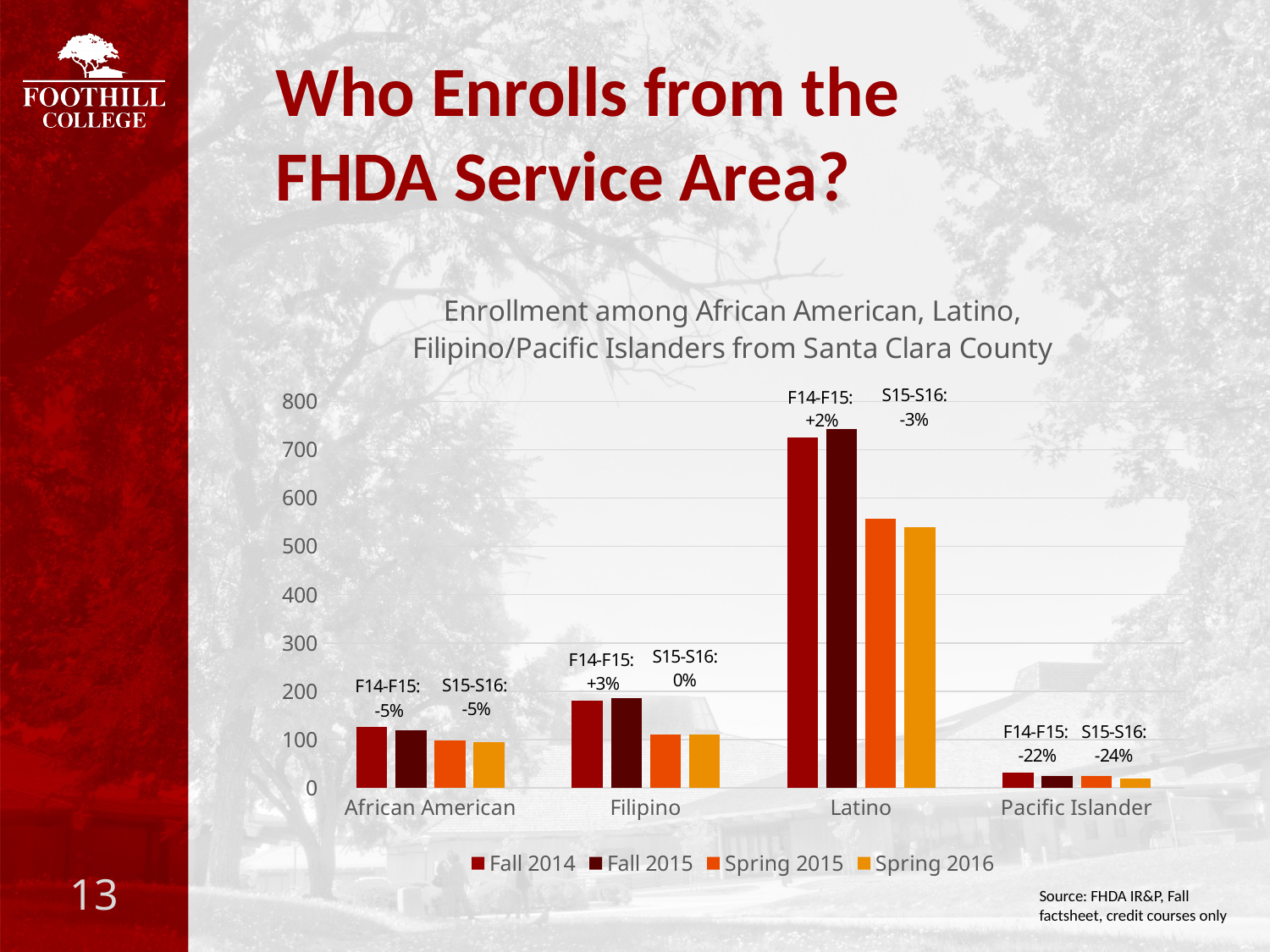
What kind of chart is shown on the slide? bar chart Is the Fall 2014 value for Filipino greater or less than 100? greater Which category has the lowest enrollment in the chart? Pacific Islander Which is larger: the Fall 2014 value for Latino or the Fall 2014 value for Filipino? Latino Which category has the highest enrollment in the chart? Latino What S15-S16 percentage change is annotated for Filipino? 0% Is the Spring 2015 value for Pacific Islander greater or less than 100? less Is the Fall 2015 value for Latino greater or less than 700? greater What F14-F15 percentage change is annotated for Pacific Islander? -22% How many categories are shown on the x axis of the chart? 4 How many series does the chart's legend list? 4